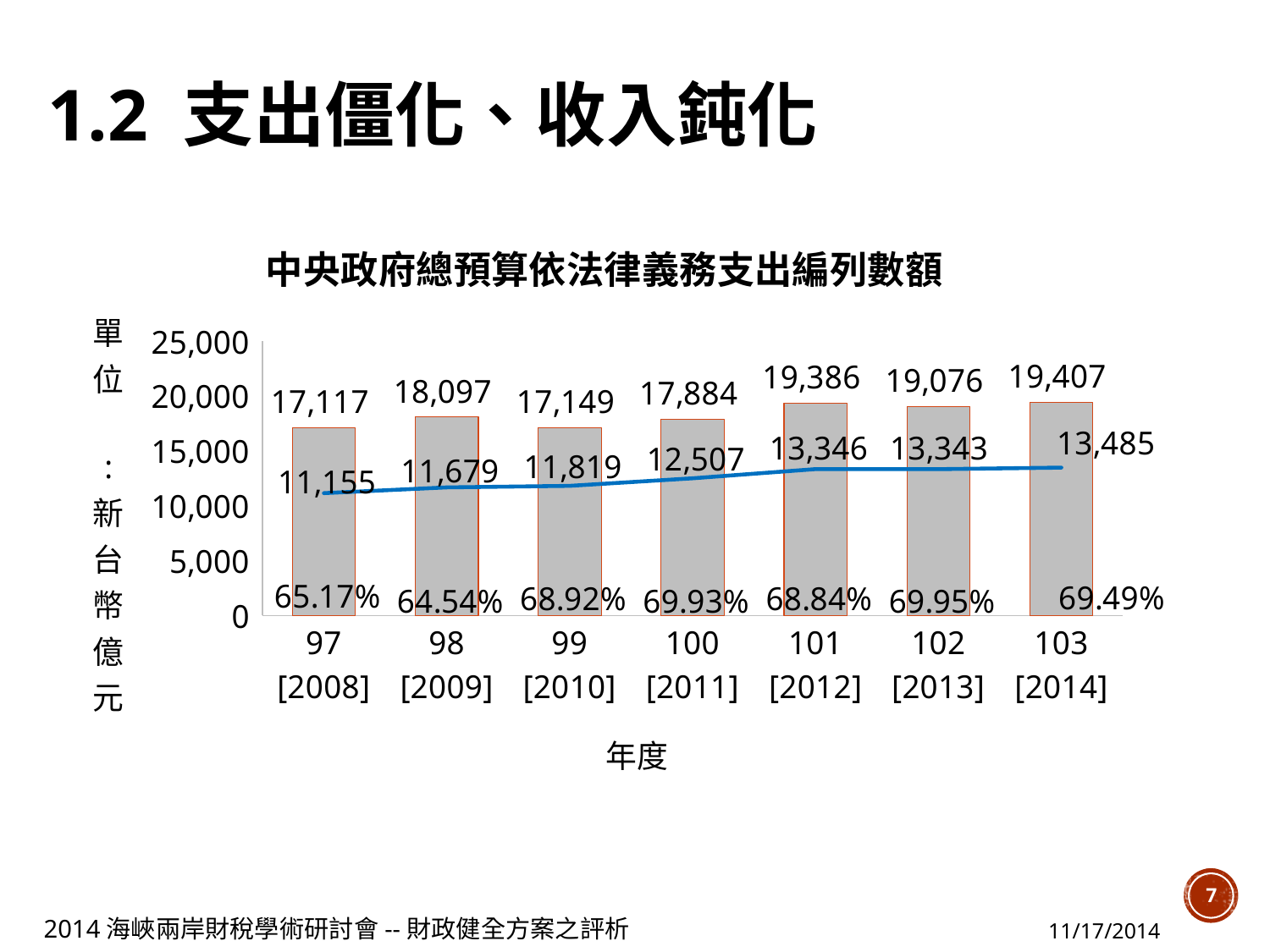
Which year has the lowest line value? 97 [2008] Does the line generally rise or fall from year 97 [2008] to year 103 [2014]? rise Which bar is taller, year 98 [2009] or year 99 [2010]? 98 [2009] What is the title of the chart? 中央政府總預算依法律義務支出編列數額 Which year has the highest bar value? 103 [2014] What is the value of the line data point for year 100 [2011]? 12,507 How many years are shown on the x axis? 7 What is the difference between the bar values for year 103 [2014] and year 97 [2008]? 2,290 What is the value of the bar for year 101 [2012]? 19,386 Is the bar value for year 98 [2009] greater or less than 15,000? greater What kind of chart is this? Bar chart with a line What percentage is shown for year 102 [2013]? 69.95%